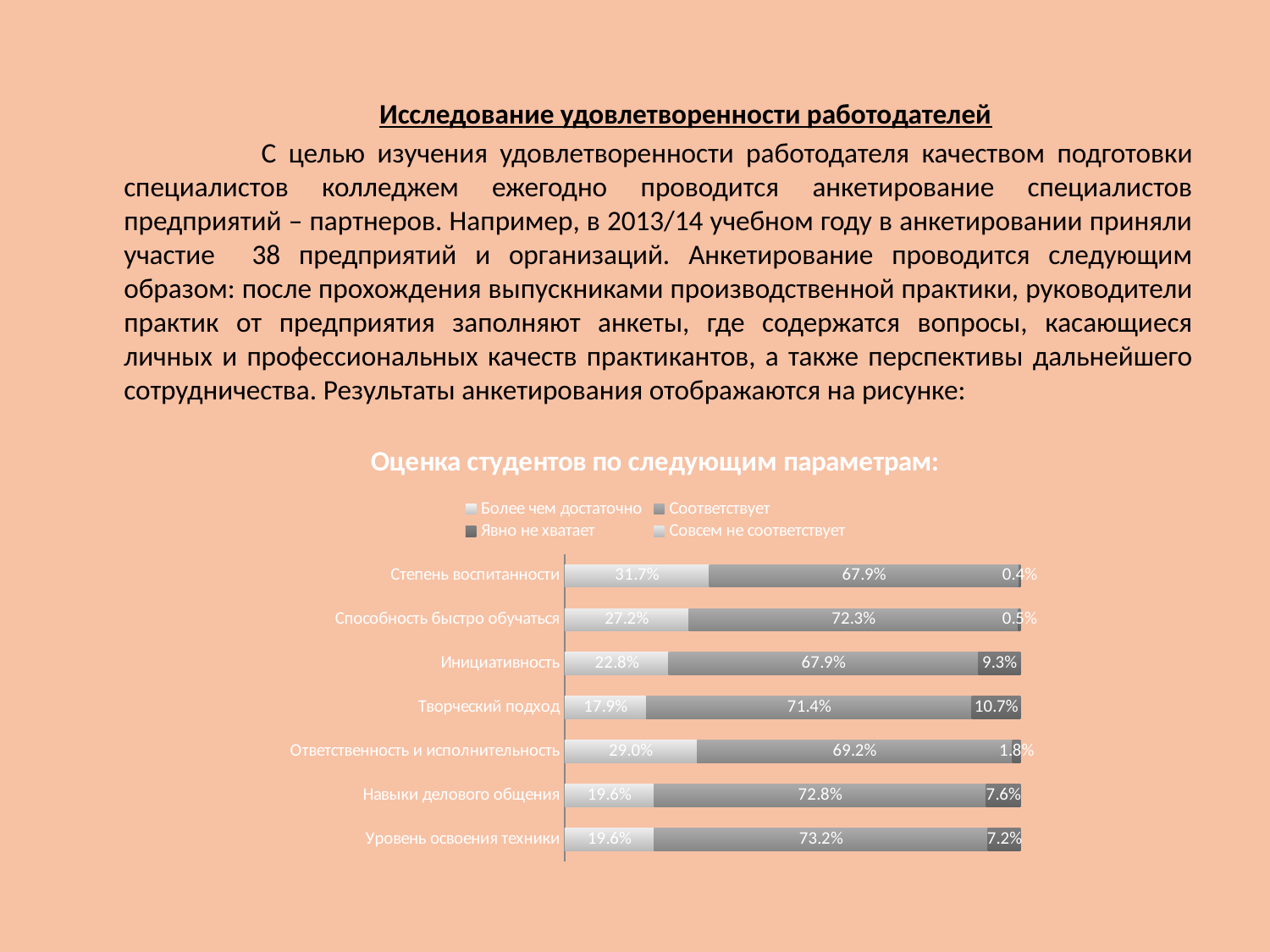
What is the title of the chart? Оценка студентов по следующим параметрам: What is the value of 'Соответствует' for 'Уровень освоения техники'? 73.2% How many categories (parameters) are plotted in the chart? 7 What is the value of 'Более чем достаточно' for 'Степень воспитанности'? 31.7% Which category has the highest value for 'Соответствует'? Уровень освоения техники What is the value of 'Явно не хватает' for 'Творческий подход'? 10.7% Which is larger: the 'Соответствует' value for 'Навыки делового общения' or for 'Творческий подход'? Навыки делового общения Which category has the highest value for 'Более чем достаточно'? Степень воспитанности Which category has the lowest value for 'Более чем достаточно'? Творческий подход What kind of chart is shown on the slide? Bar chart How many series does the chart legend list? 4 For 'Способность быстро обучаться', what is the difference between the 'Соответствует' value and the 'Более чем достаточно' value? 45.1 percentage points